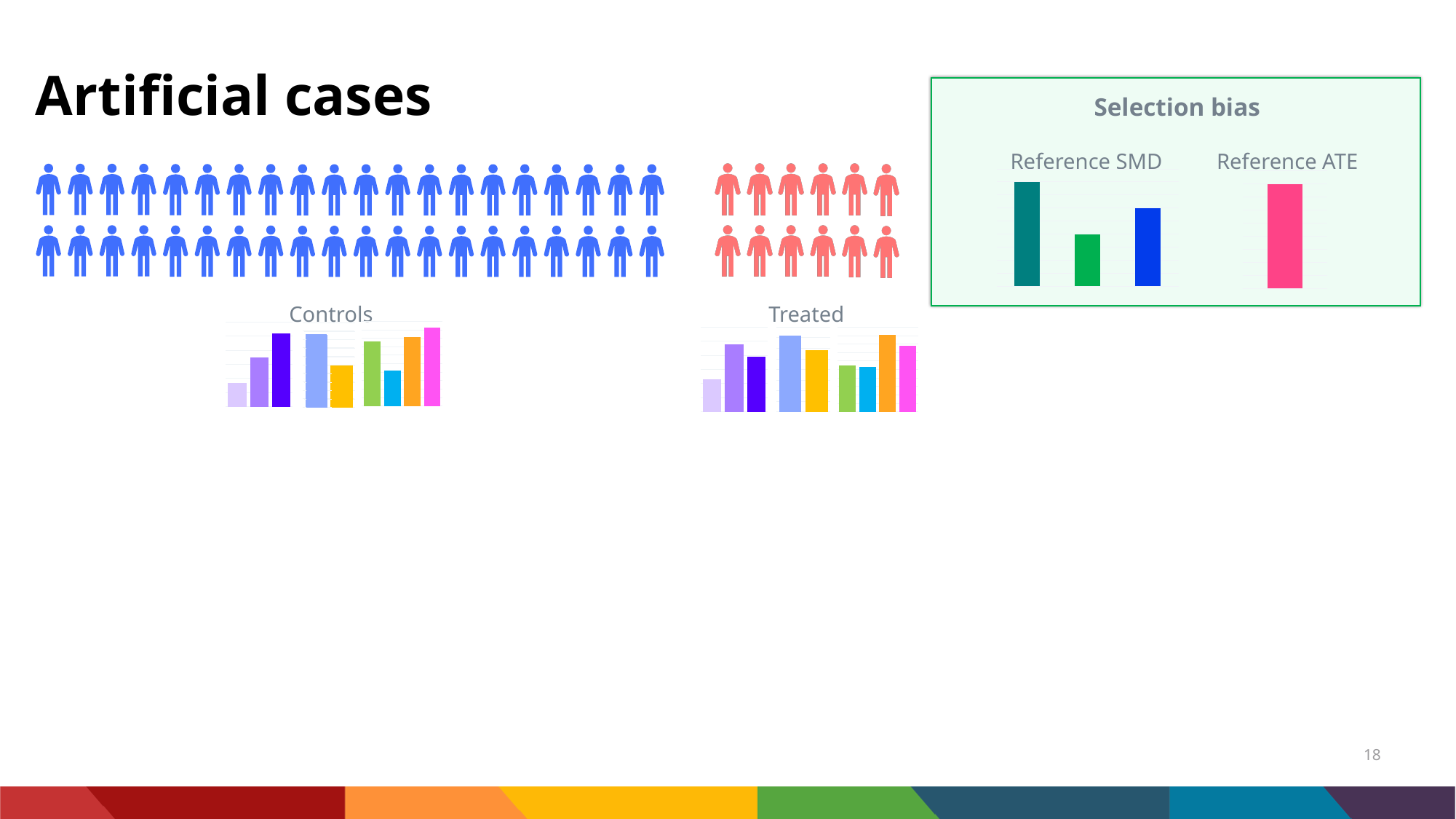
How many bars are shown under 'Reference SMD' in the 'Selection bias' box? 3 In the 'Reference SMD' chart, is the first bar taller or shorter than the middle bar? taller In the 'Reference SMD' chart, which bar is the shortest? the middle (green) bar What is the title of the green box containing the 'Reference SMD' and 'Reference ATE' charts? Selection bias How many bars are shown under 'Reference ATE' in the 'Selection bias' box? 1 What are the labels of the two small bar charts below the person icons? Controls and Treated How many bars does the 'Controls' chart contain? 9 What kind of chart is the 'Controls' chart? bar chart In the 'Reference SMD' chart, which bar is the tallest? the first (teal) bar In the 'Treated' chart, is the first bar taller or shorter than the second bar? shorter In the 'Controls' chart, which bar is the shortest? the first (light purple) bar